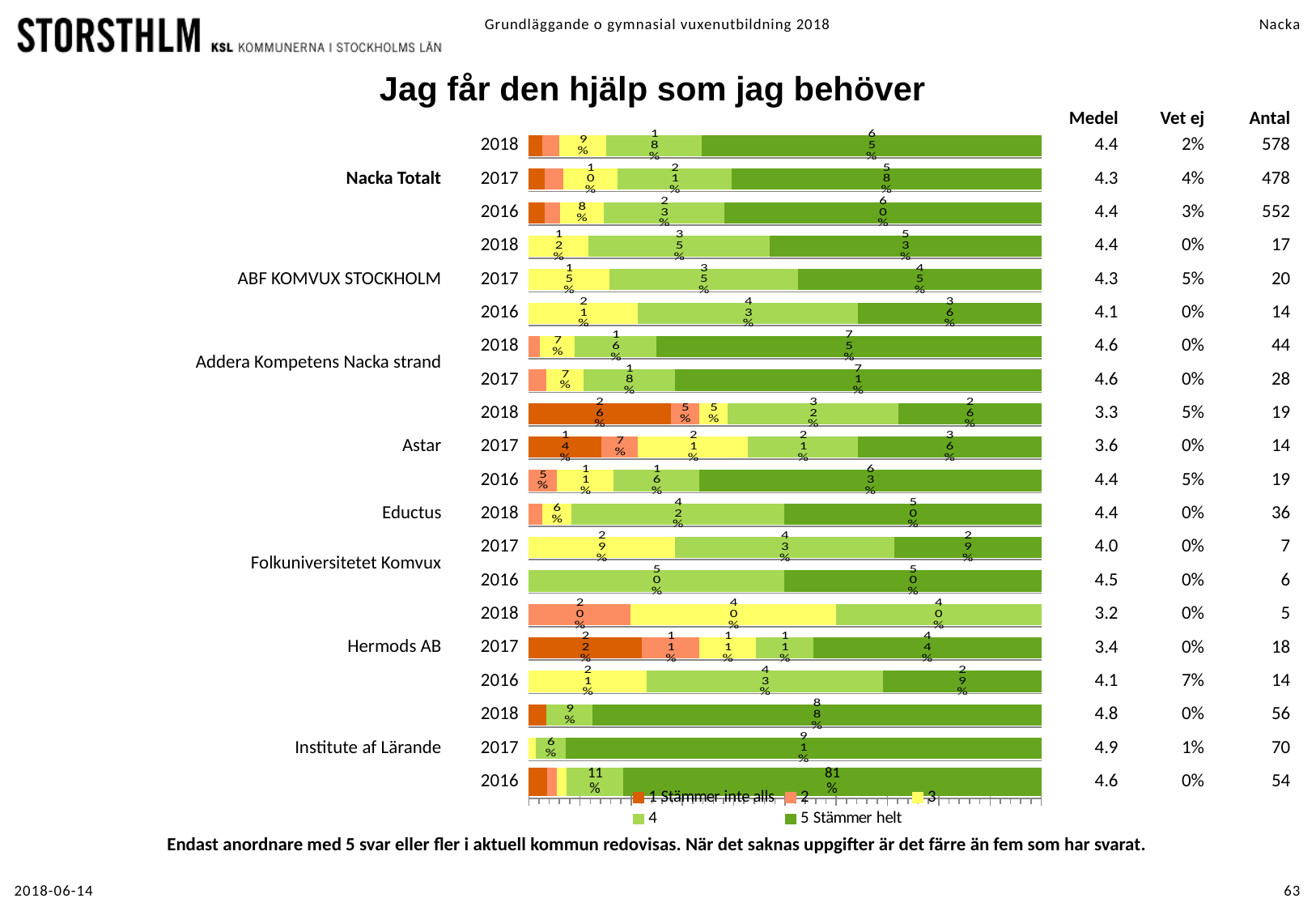
What percentage of Astar respondents in 2018 answered "1 Stämmer inte alls"? 26% What percentage of Institute af Lärande respondents in 2017 answered "5 Stämmer helt"? 91% What percentage of Hermods AB respondents in 2018 answered "3"? 40% By how many percentage points did the "5 Stämmer helt" share for Nacka Totalt change from 2017 to 2018? 7 percentage points How many series does the chart legend list? 5 Which legend entry is shown in the darkest green colour? 5 Stämmer helt For Addera Kompetens Nacka strand, which year has the larger share of "5 Stämmer helt", 2018 or 2017? 2018 Which year has the highest "5 Stämmer helt" share for Institute af Lärande? 2017 What percentage of Folkuniversitetet Komvux respondents in 2016 answered "5 Stämmer helt"? 50% What percentage of Eductus respondents in 2018 answered "4"? 42% What percentage of Nacka Totalt respondents in 2018 answered "5 Stämmer helt"? 65% What kind of chart is shown on the slide? Stacked bar chart